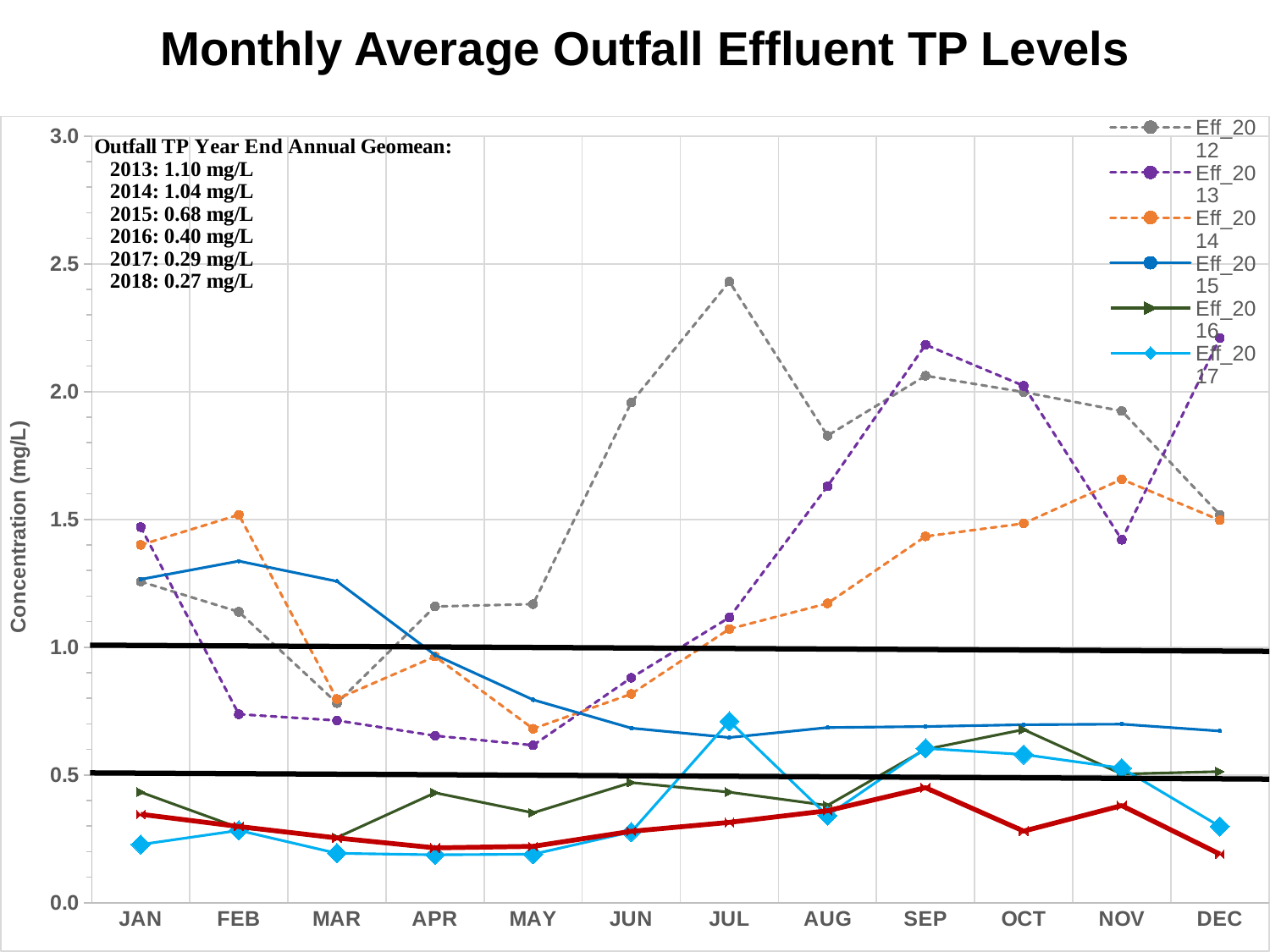
In which month is the Eff_2014 series at its lowest value? MAY According to the text box on the chart, what is the 2016 Outfall TP year end annual geomean? 0.40 mg/L In JUL, which series has the larger value, Eff_2016 or Eff_2017? Eff_2017 What kind of chart is shown on the slide? line chart Is the value for Eff_2015 in JAN greater or less than 1.0? greater Does the Eff_2014 series rise or fall from MAY to NOV? rise Is the value for Eff_2016 in MAY greater or less than 0.5? less Is the value for Eff_2012 in JUL greater or less than 2.0? greater In which month does the Eff_2012 series reach its highest value? JUL How many months are shown along the x axis? 12 In which month does the Eff_2014 series reach its highest value? NOV How many series does the legend list? 6